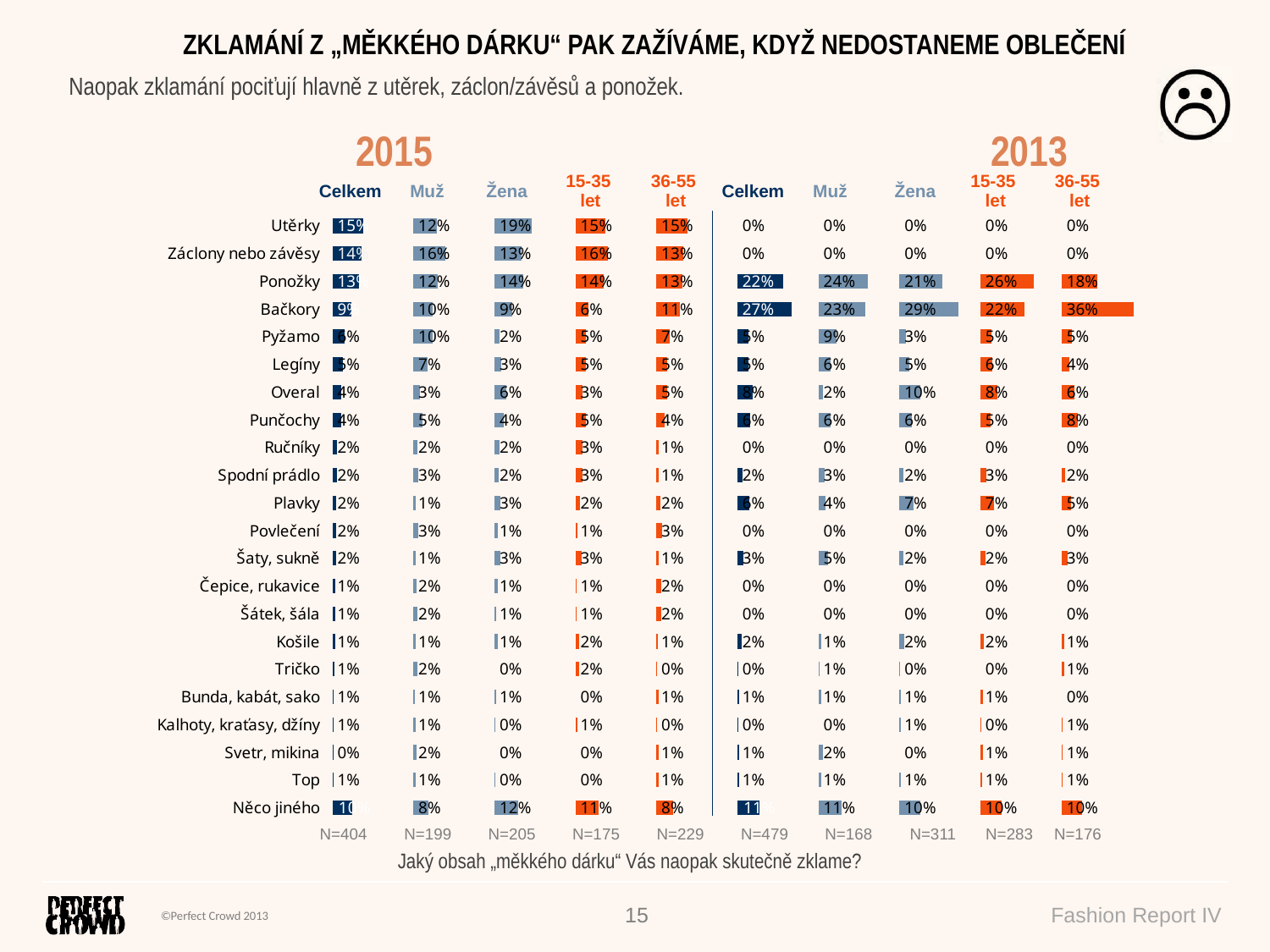
How many categories (rows) are listed in the chart? 22 What is the difference between the 2013 Celkem value and the 2015 Celkem value for Bačkory? 18% What kind of chart is used to show the values on this slide? Bar chart In the 2013 36-55 let column, what is the value for Bačkory? 36% What is the sample size (N) shown for the 2013 Celkem column? N=479 In the 2013 15-35 let column, what is the value for Ponožky? 26% What is the difference between the 2015 Žena value and the 2015 Muž value for Utěrky? 7% In the 2015 Žena column, what is the value for Pyžamo? 2% In the 2013 Celkem column, which category has the highest value? Bačkory In the 2015 Celkem column, what is the value for Utěrky? 15% For Ponožky in 2013, which is larger: the Muž value or the Žena value? Muž In the 2015 Celkem column, which category has the highest value? Utěrky